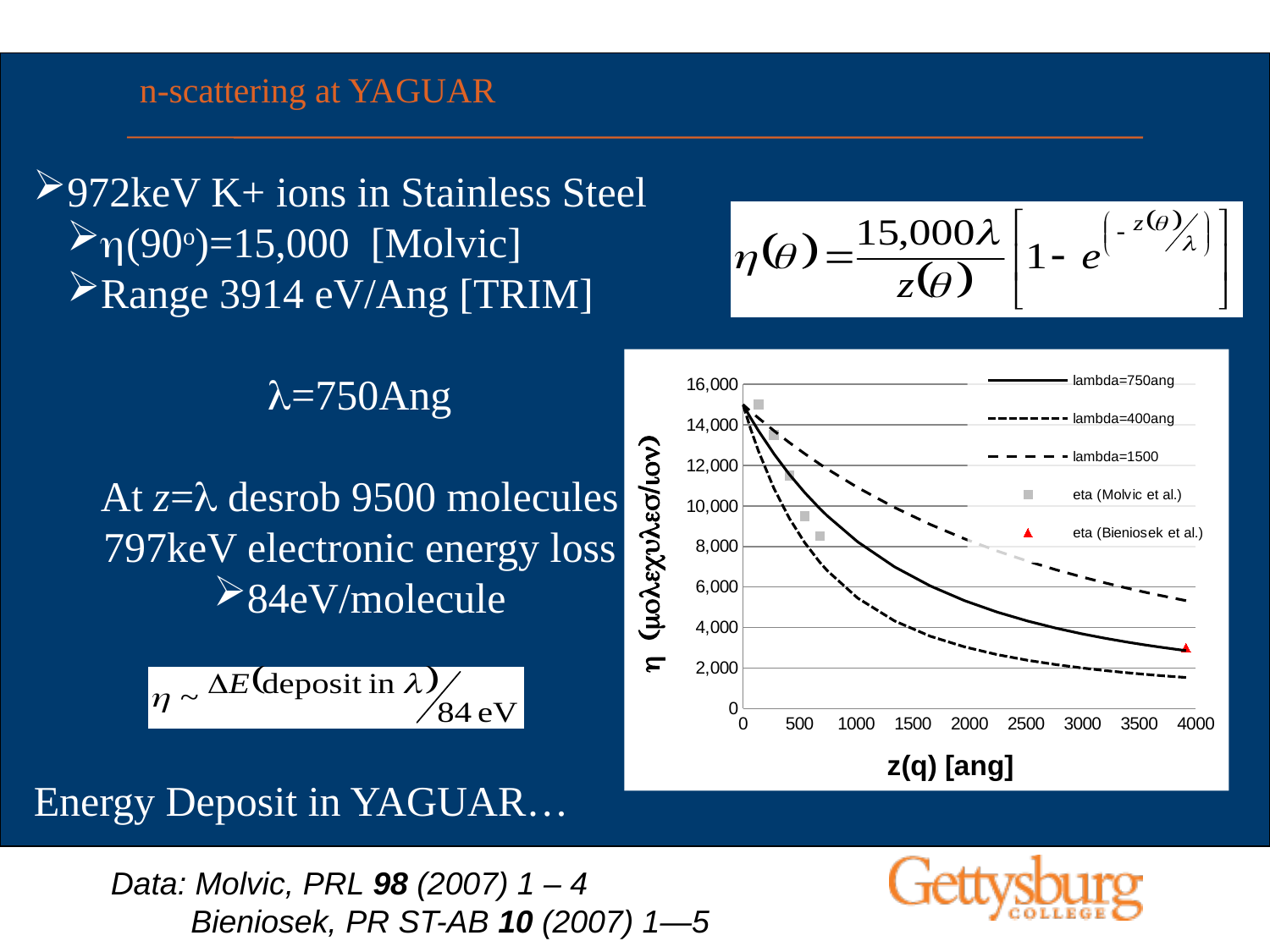
Do the lambda curves rise or fall as z(q) increases? fall What kind of chart is shown on the slide? line chart Which lambda curve is lowest at z(q) = 4000? lambda=400ang Is the value of the lambda=1500 curve at z(q) = 4000 greater or less than 4,000? greater Is the value of the lambda=400ang curve at z(q) = 4000 greater or less than 2,000? less What is the x-axis title of the chart? z(q) [ang] Which lambda curve is highest at z(q) = 4000? lambda=1500 At z(q) = 2000, which curve is higher: lambda=1500 or lambda=400ang? lambda=1500 How many eta (Bieniosek et al.) data points are plotted? 1 Which legend entry is drawn as a solid line? lambda=750ang Is the eta (Bieniosek et al.) data point greater or less than 2,000? greater How many series does the chart legend list? 5